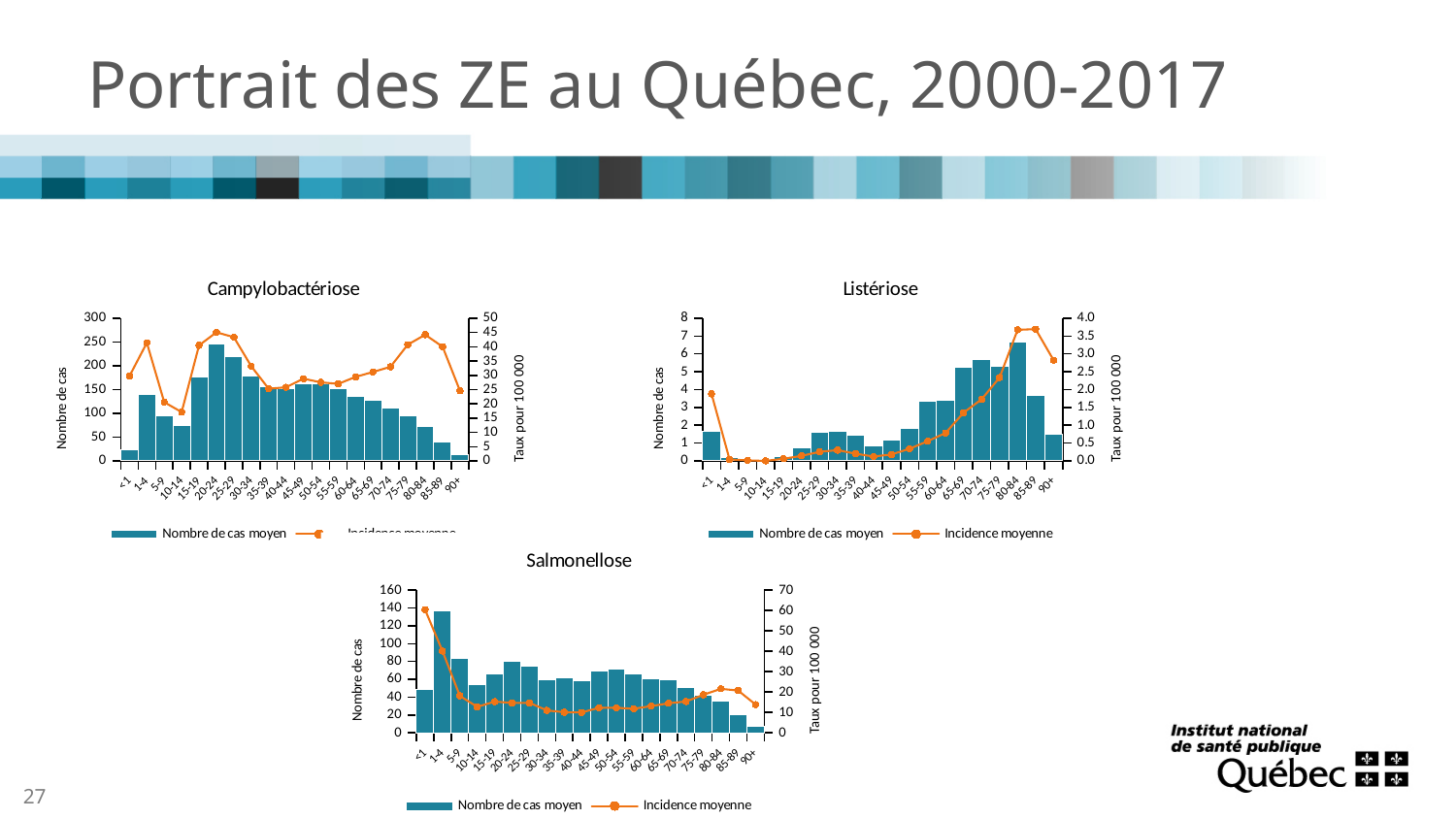
In the Salmonellose chart, which has the larger Nombre de cas moyen bar, 1-4 or 5-9? 1-4 In the Campylobactériose chart, which age group has the lowest bar for Nombre de cas moyen? 90+ In the Salmonellose chart, which age group has the highest bar for Nombre de cas moyen? 1-4 What are the two legend entries in the Salmonellose chart? Nombre de cas moyen and Incidence moyenne What kind of chart is the Campylobactériose chart? A combined bar and line chart In the Campylobactériose chart, which age group has the highest bar for Nombre de cas moyen? 20-24 In the Campylobactériose chart, is the Nombre de cas moyen bar for 20-24 greater or less than 200? greater In the Listériose chart, is the Nombre de cas moyen bar for 80-84 greater or less than 5? greater How many series does the legend of the Listériose chart list? 2 In the Salmonellose chart, is the Incidence moyenne value for <1 greater or less than 50? greater How many age categories are shown on the x axis of the Salmonellose chart? 20 In the Listériose chart, which age group has the highest bar for Nombre de cas moyen? 80-84